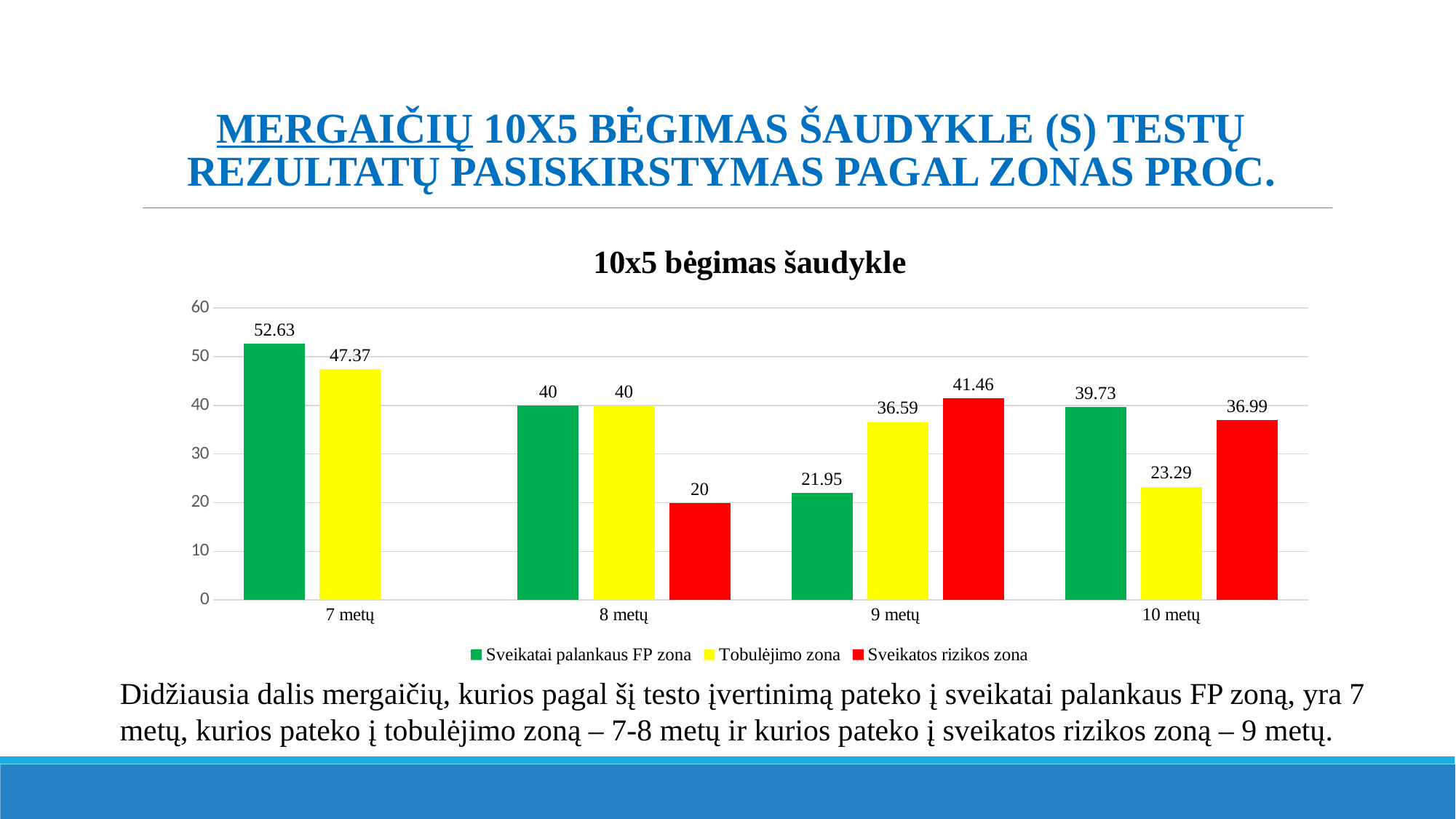
What is the difference between the Sveikatai palankaus FP zona and Tobulėjimo zona values for 7 metų? 5.26 What is the value for Tobulėjimo zona for 10 metų? 23.29 How many series does the legend list? 3 For 10 metų, which is larger: Sveikatai palankaus FP zona or Sveikatos rizikos zona? Sveikatai palankaus FP zona Which age group has the highest value for Sveikatai palankaus FP zona? 7 metų What is the value for Sveikatai palankaus FP zona for 7 metų? 52.63 What is the value for Sveikatos rizikos zona for 9 metų? 41.46 What is the difference between the Sveikatos rizikos zona values for 9 metų and 8 metų? 21.46 What kind of chart is shown on the slide? bar chart How many age groups are shown on the x axis? 4 Which age group has the lowest value for Sveikatai palankaus FP zona? 9 metų Is the value for Sveikatos rizikos zona for 8 metų greater or less than 30? less